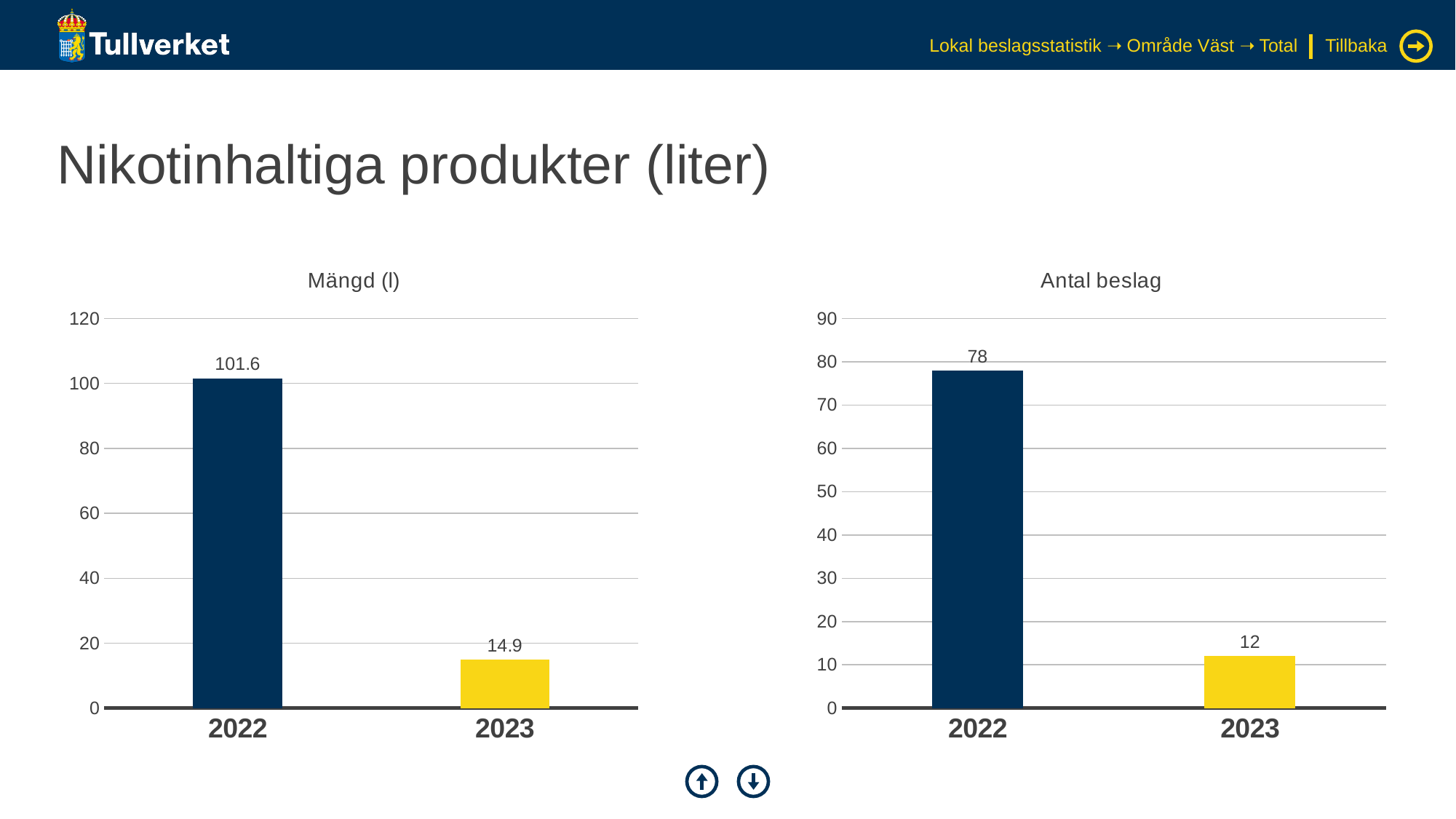
In the 'Antal beslag' chart, is the value for 2022 greater or less than 70? greater In the 'Mängd (l)' chart, what is the value for 2022? 101.6 How many categories are shown on the x axis of the 'Mängd (l)' chart? 2 In the 'Mängd (l)' chart, what is the difference between the 2022 and 2023 values? 86.7 In the 'Mängd (l)' chart, what is the value for 2023? 14.9 In the 'Antal beslag' chart, what is the difference between the 2022 and 2023 values? 66 In the 'Mängd (l)' chart, which year has the highest value? 2022 What kind of chart is the 'Antal beslag' chart? bar chart In the 'Mängd (l)' chart, do the values rise or fall from 2022 to 2023? fall In the 'Antal beslag' chart, what is the value for 2022? 78 In the 'Antal beslag' chart, which year has the lowest value? 2023 In the 'Antal beslag' chart, what is the value for 2023? 12